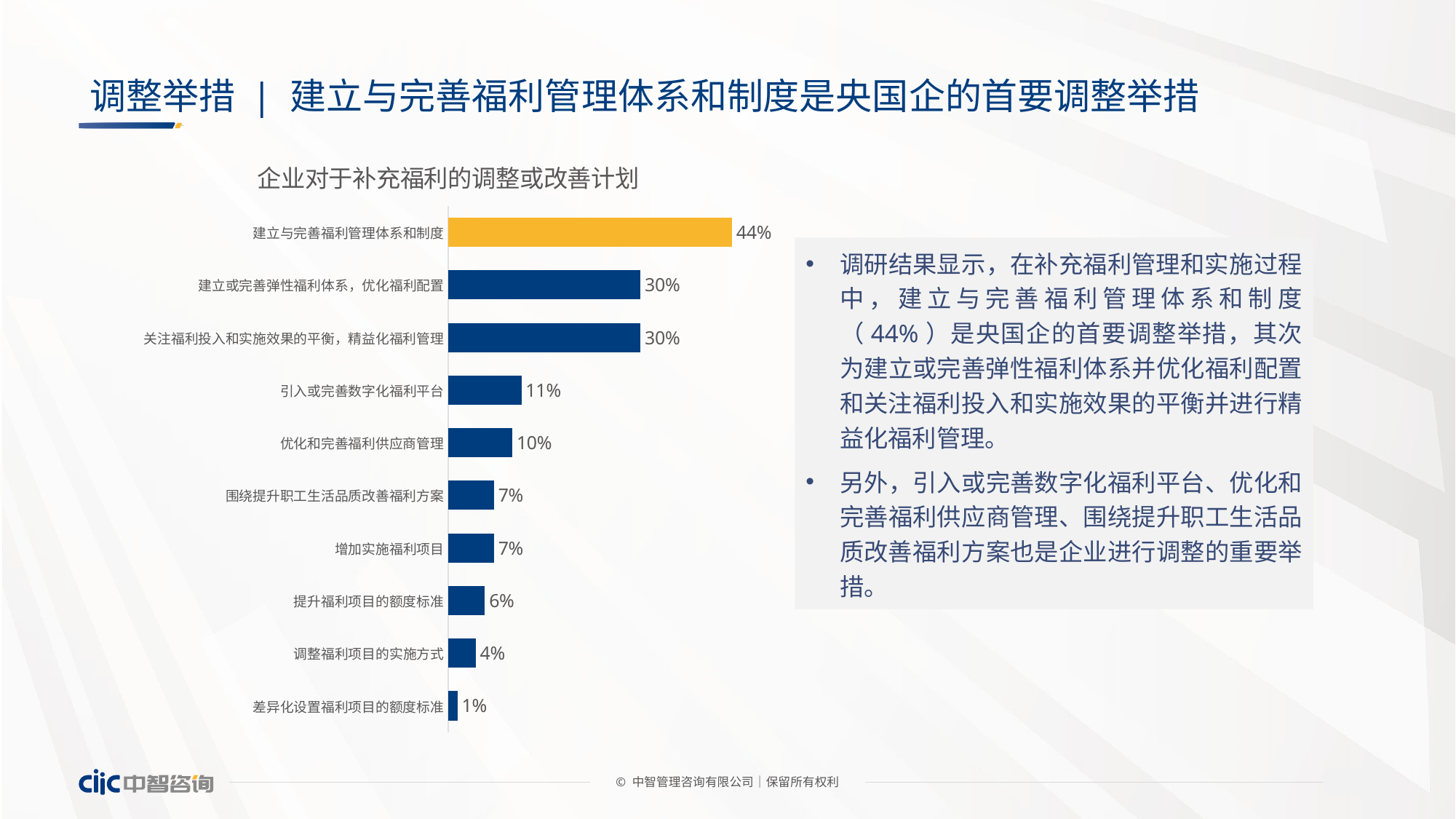
How many categories are shown in the chart? 10 What is the difference between the values for 引入或完善数字化福利平台 and 优化和完善福利供应商管理? 1% Which category has the lowest value? 差异化设置福利项目的额度标准 What is the title of the chart? 企业对于补充福利的调整或改善计划 Which category has the highest value? 建立与完善福利管理体系和制度 What kind of chart is shown on the slide? Bar chart Which bar is coloured differently (yellow) from the others? 建立与完善福利管理体系和制度 What is the value for 引入或完善数字化福利平台? 11% What is the value for 调整福利项目的实施方式? 4% What is the value for 建立与完善福利管理体系和制度? 44% Which is larger, the value for 优化和完善福利供应商管理 or the value for 提升福利项目的额度标准? 优化和完善福利供应商管理 What is the difference between the values for 建立与完善福利管理体系和制度 and 建立或完善弹性福利体系，优化福利配置? 14%